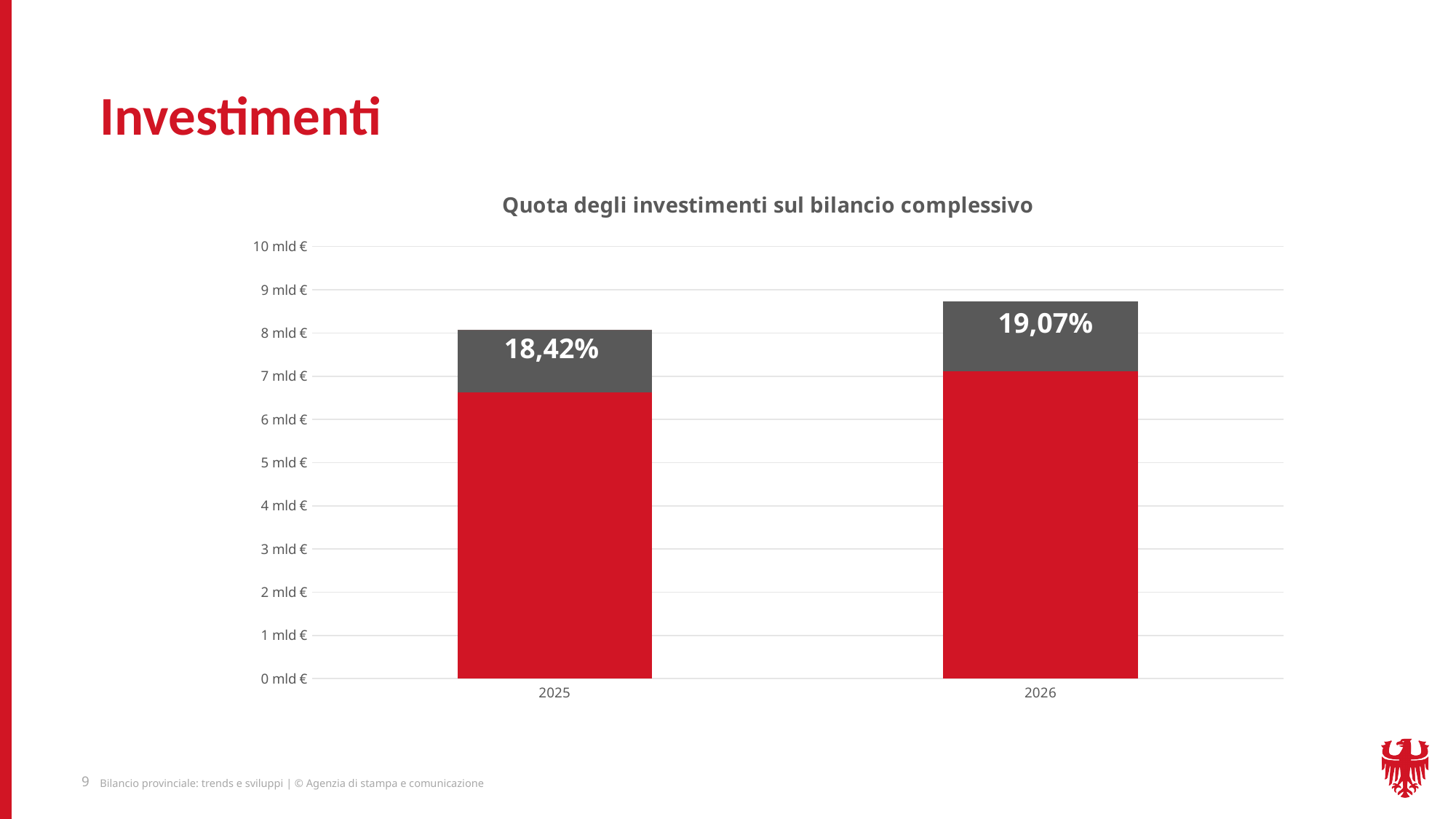
What percentage is printed on the 2026 bar? 19,07% What kind of chart is shown on the slide? bar chart What percentage is printed on the 2025 bar? 18,42% Is the total height of the 2026 bar greater or less than 9 mld €? less Is the red segment of the 2025 bar greater or less than 6 mld €? greater How many years are shown on the x axis? 2 Does the percentage label rise or fall from 2025 to 2026? rise Which year shows the higher percentage label, 2025 or 2026? 2026 What is the title of the chart? Quota degli investimenti sul bilancio complessivo Is the total height of the 2025 bar greater or less than 7 mld €? greater Which year has the taller total bar? 2026 By how many percentage points does the 2026 label exceed the 2025 label? 0,65%